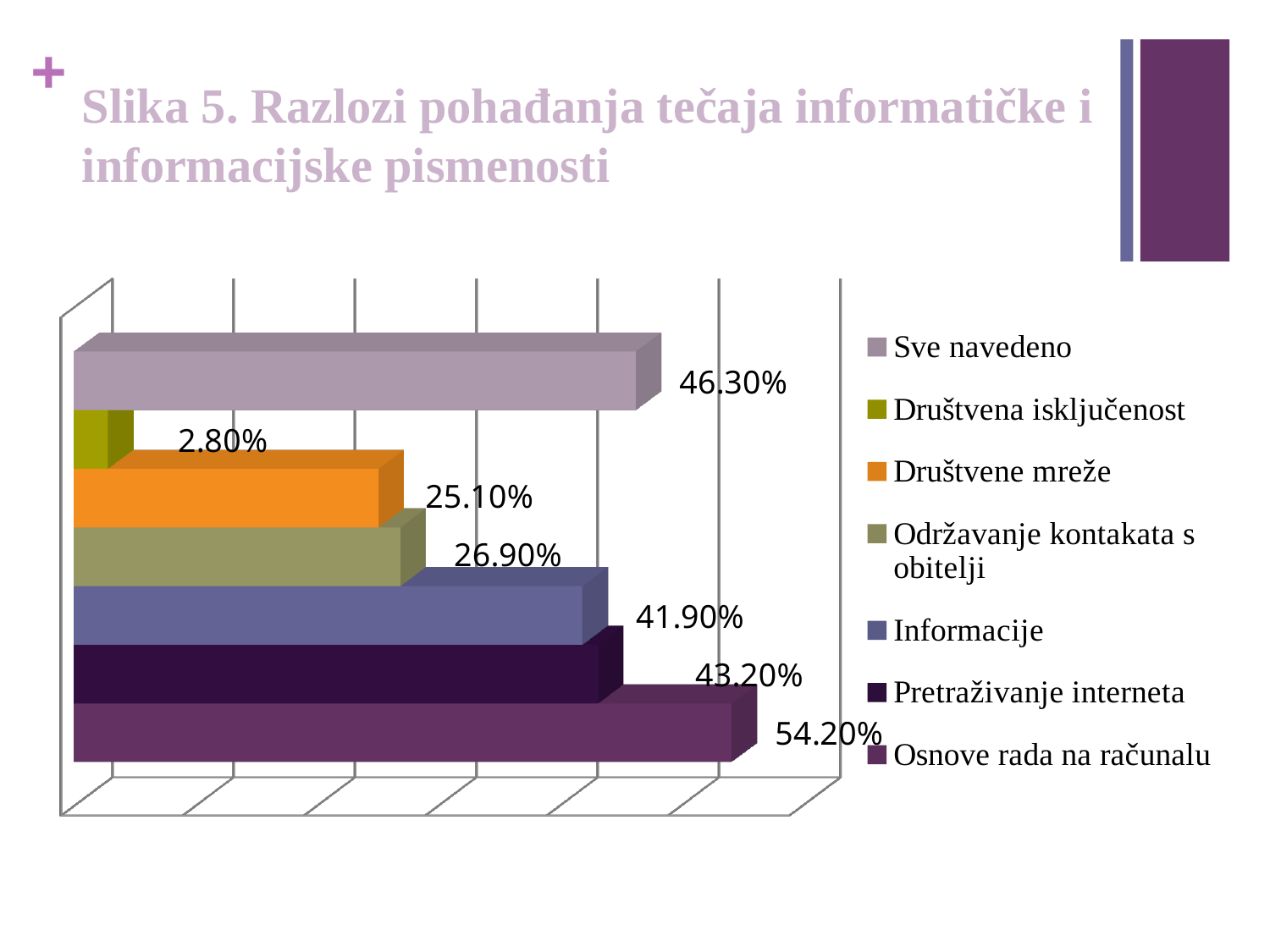
What value is shown for Društvena isključenost? 2.80% What value is shown for Informacije? 41.90% What is the difference between the values for Osnove rada na računalu and Sve navedeno? 7.90% What value is shown for Društvene mreže? 25.10% Which is larger, the value for Pretraživanje interneta or the value for Informacije? Pretraživanje interneta Which category has the lowest value? Društvena isključenost What value is shown for Osnove rada na računalu? 54.20% What colour is the bar for Društvene mreže? Orange Which category has the highest value? Osnove rada na računalu What is the difference between the values for Održavanje kontakata s obitelji and Društvene mreže? 1.80% What kind of chart is shown on the slide? Bar chart How many entries does the legend list? 7